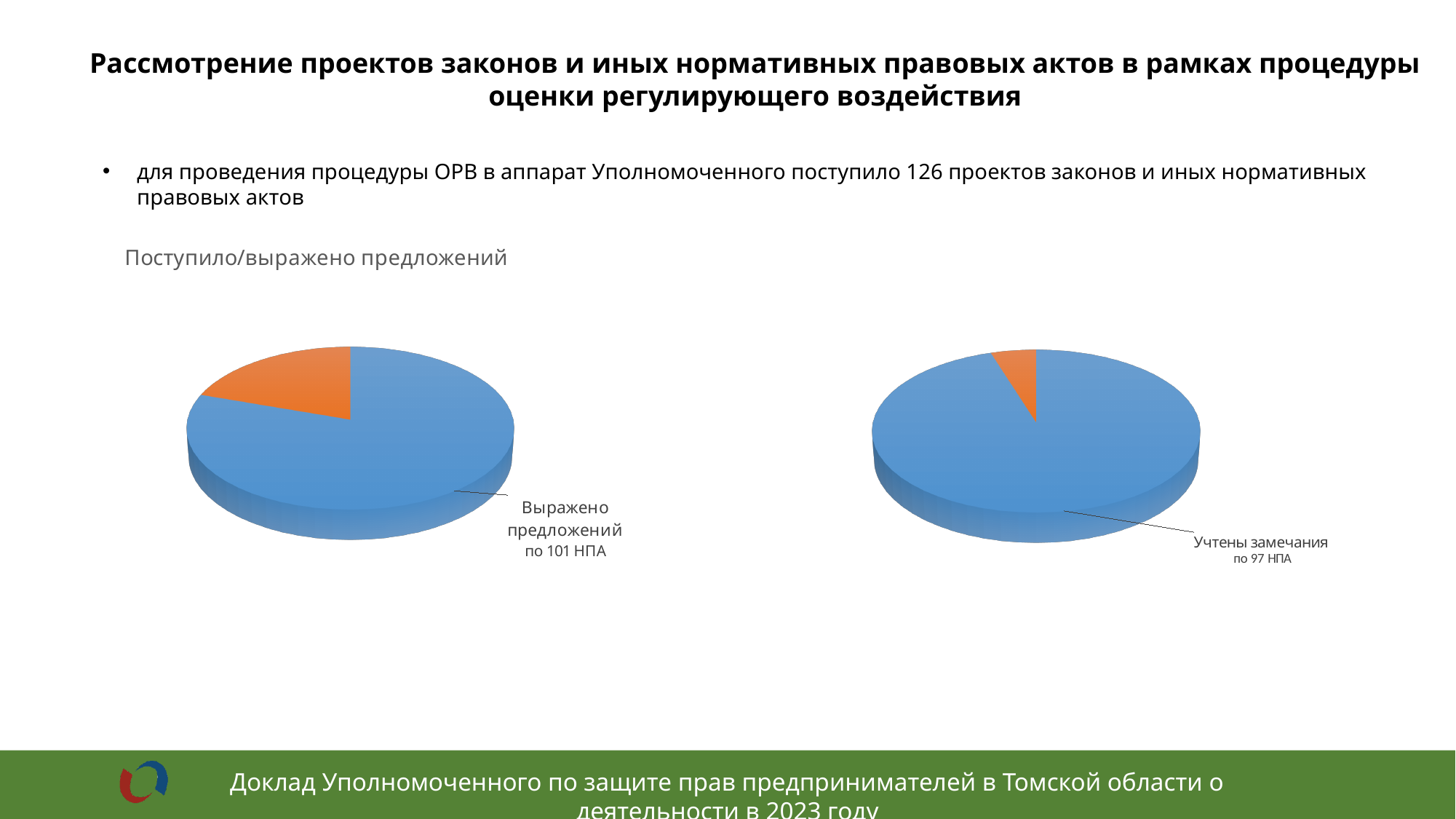
In the left chart titled "Поступило/выражено предложений", which slice is the smallest? the orange slice In the left chart titled "Поступило/выражено предложений", how many slices does the pie have? 2 In the left chart titled "Поступило/выражено предложений", for how many НПА were proposals expressed according to the data label? 101 НПА In the chart on the right side of the slide, how many slices does the pie have? 2 In the chart on the right side of the slide, what is the label attached to the blue slice? Учтены замечания по 97 НПА What kind of chart is the chart on the right side of the slide? pie chart In the left chart titled "Поступило/выражено предложений", what is the label attached to the blue slice? Выражено предложений по 101 НПА What kind of chart is the left chart titled "Поступило/выражено предложений"? pie chart In the left chart titled "Поступило/выражено предложений", which slice is larger, the blue one or the orange one? the blue one In the chart on the right side of the slide, for how many НПА were remarks taken into account according to the data label? 97 НПА In the chart on the right side of the slide, which slice is larger, the blue one or the orange one? the blue one In the chart on the right side of the slide, which slice is the largest? the blue slice (Учтены замечания по 97 НПА)